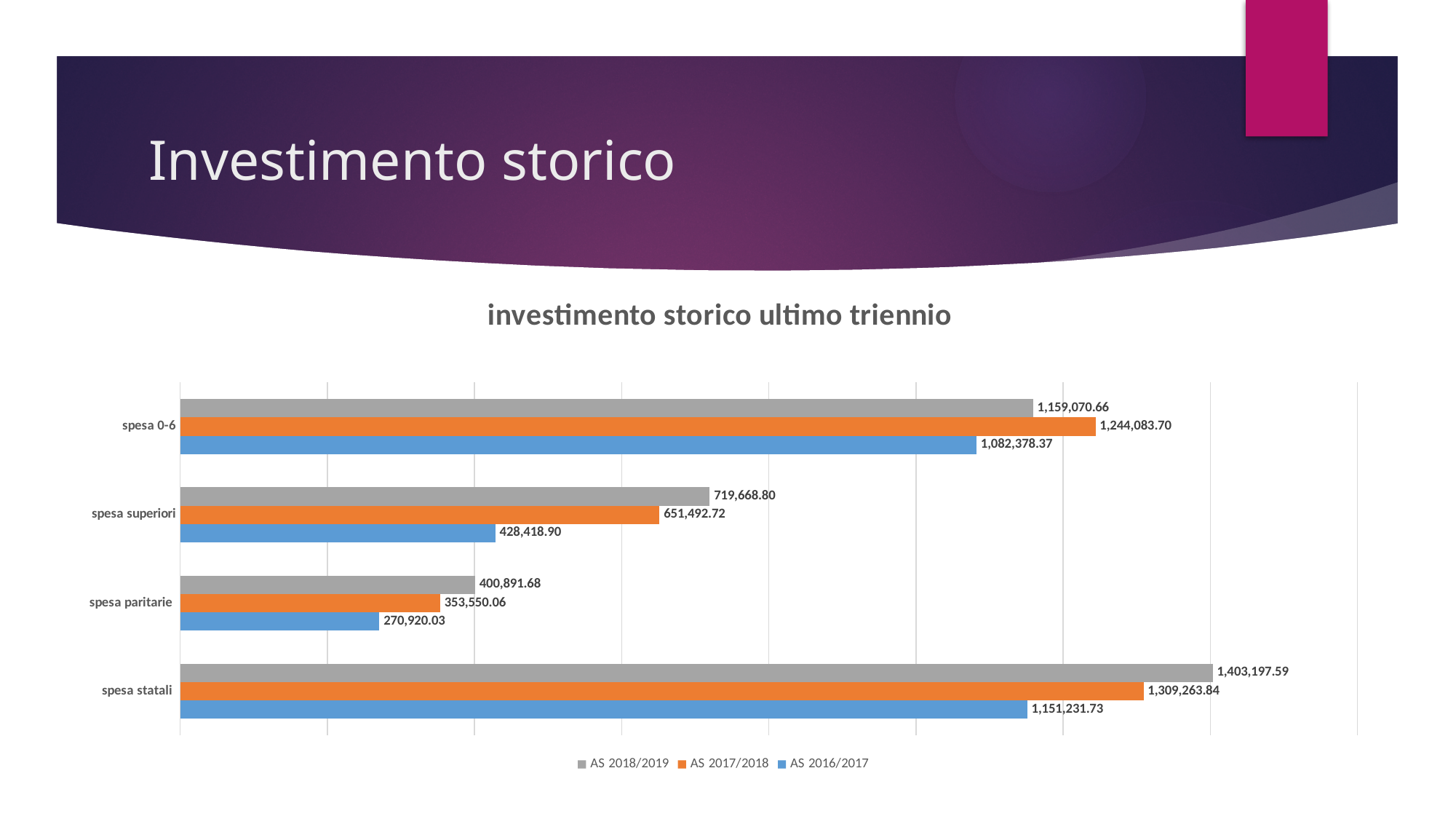
What is the title of the chart? investimento storico ultimo triennio What is the value for spesa statali in AS 2018/2019? 1,403,197.59 What is the value for spesa 0-6 in AS 2017/2018? 1,244,083.70 Which category has the lowest value in AS 2018/2019? spesa paritarie How many categories are shown on the chart? 4 What is the difference between the AS 2018/2019 and AS 2017/2018 values for spesa statali? 93,933.75 Which category has the highest value in AS 2016/2017? spesa statali How many series does the legend list? 3 What is the value for spesa paritarie in AS 2016/2017? 270,920.03 Do the values for spesa superiori rise or fall from AS 2016/2017 to AS 2018/2019? rise Which is larger for spesa 0-6: the AS 2018/2019 value or the AS 2017/2018 value? AS 2017/2018 What type of chart is shown on the slide? bar chart